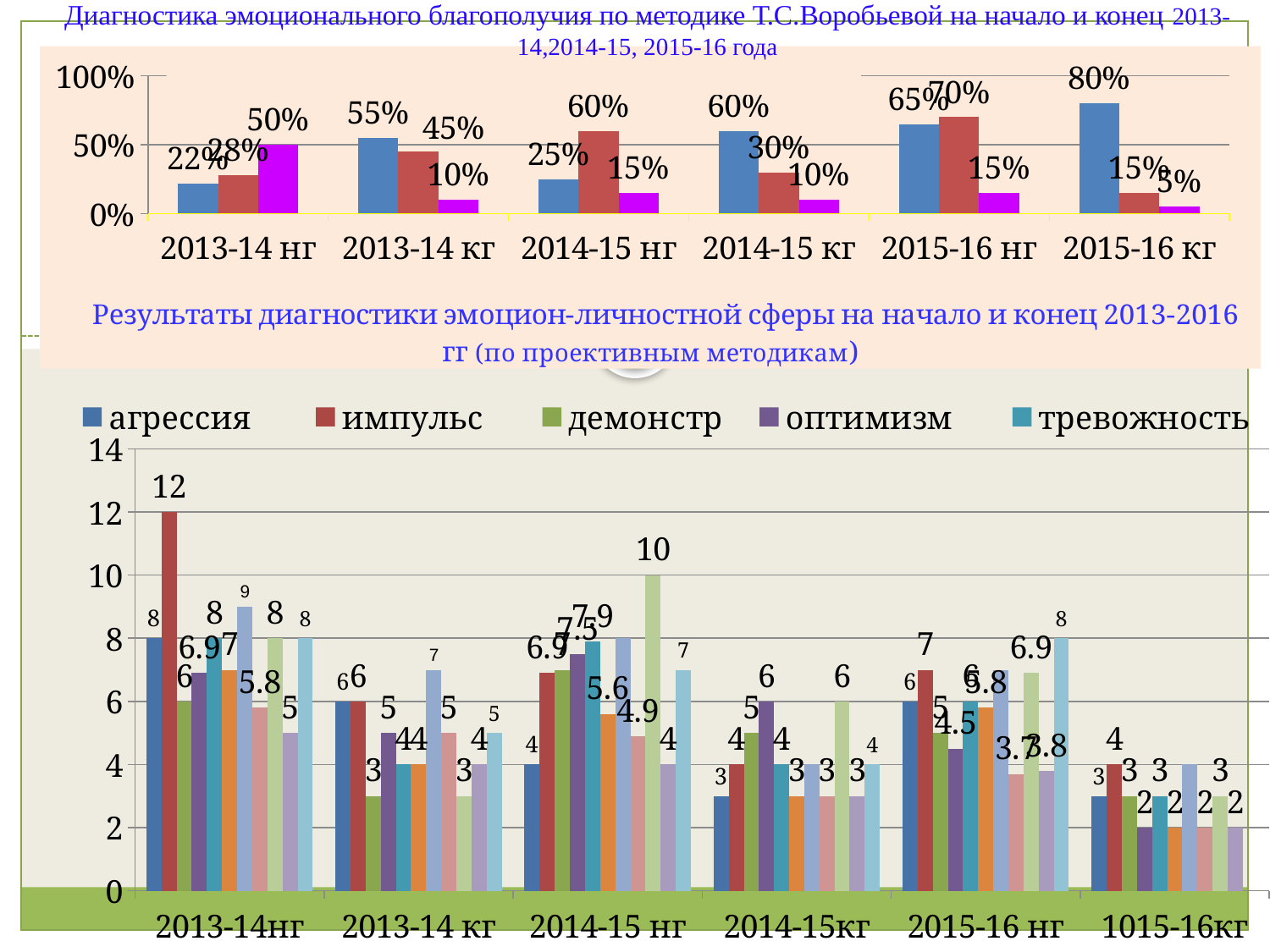
In the bottom chart, what is the value of импульс for 2013-14нг? 12 In the bottom chart, what is the value of агрессия for 2013-14нг? 8 How many series does the legend of the bottom chart list? 5 In the top chart, what value is shown for the magenta bar in the 2013-14 нг group? 50% In the top chart, what is the difference between the blue bar (55%) and the red bar (45%) in the 2013-14 кг group? 10% In the top chart, which group contains the highest value of all? 2015-16 кг How many category groups are shown on the x axis of the top chart? 6 In the bottom chart, which series has the highest value in the 2013-14нг group? импульс In the top chart, in the 2014-15 нг group, which is larger: the blue bar or the red bar? the red bar In the top chart, what value is shown for the blue bar in the 2015-16 кг group? 80% What kind of chart is the top chart? bar chart How many category groups are shown on the x axis of the bottom chart? 6